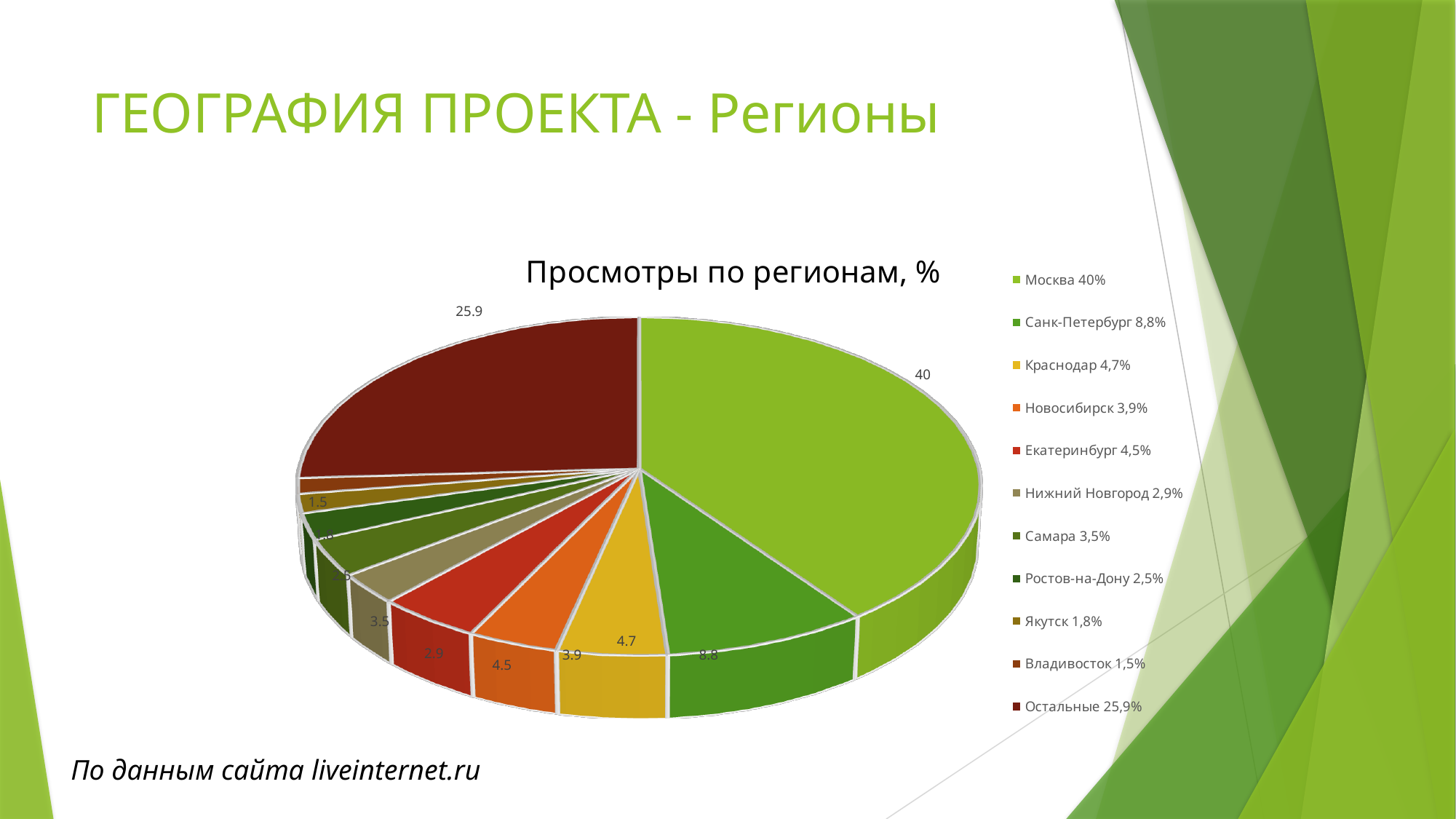
What kind of chart is shown on the slide? pie chart What value is shown for Остальные in the chart? 25.9 What value is shown for Самара in the chart? 3.5 What is the difference between the values for Краснодар and Новосибирск? 0.8 What value is shown for Санк-Петербург in the chart? 8.8 What is the title of the chart? Просмотры по регионам, % What value is shown for Москва in the chart? 40 Which region has the smallest slice of the pie? Владивосток Which region has the largest slice of the pie? Москва How many categories does the pie chart have? 11 Which has a larger value, Екатеринбург or Краснодар? Краснодар What is the difference between the values for Москва and Остальные? 14.1